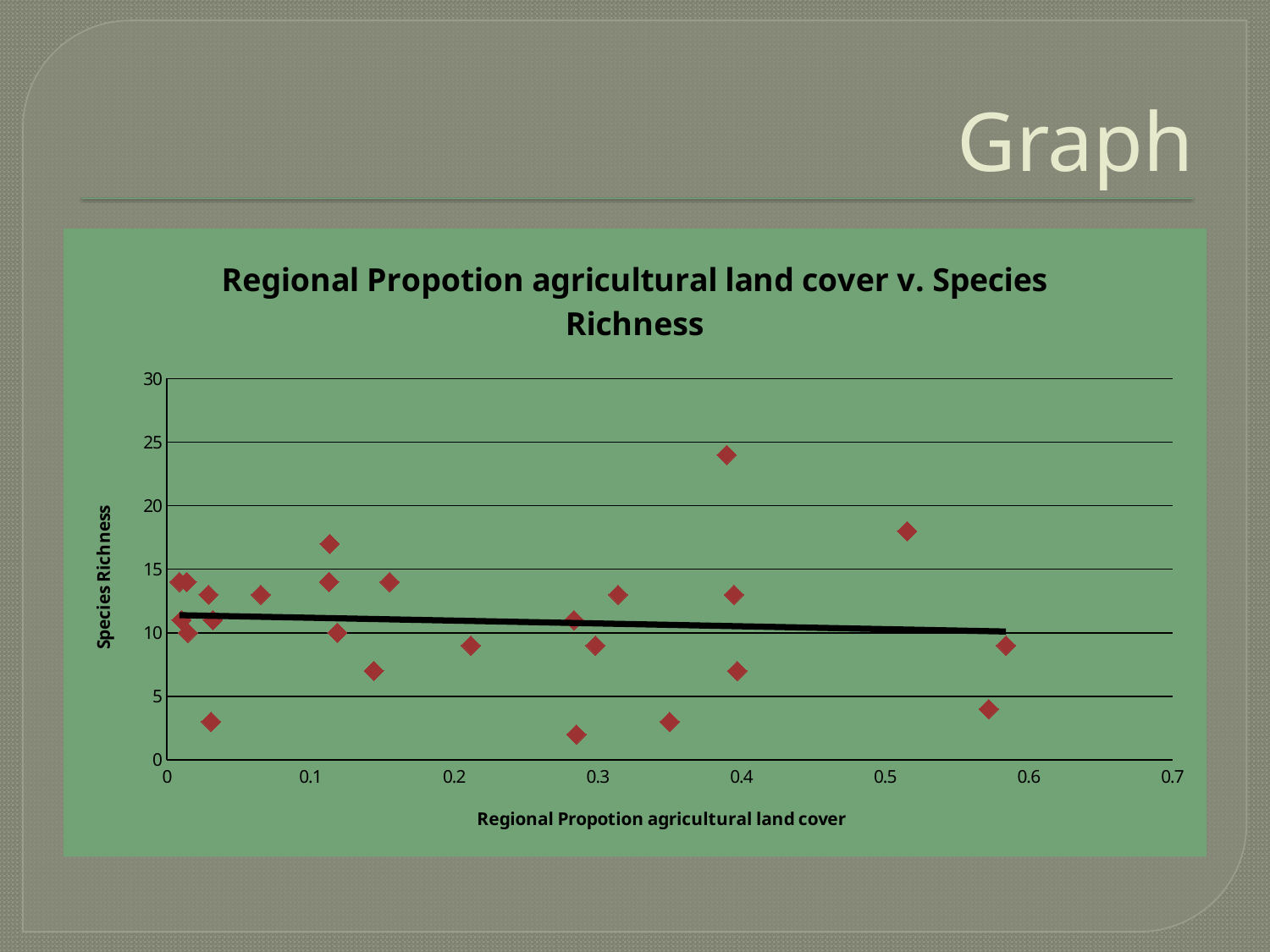
Is the value where the trend line meets the left side of the plot greater or less than 10? greater Is the species richness of the point furthest to the right on the chart greater or less than 10? less Is the species richness of the lowest point on the chart greater or less than 5? less Does the trend line in the chart rise or fall as the regional proportion of agricultural land cover increases? fall What is the title of the chart? Regional Propotion agricultural land cover v. Species Richness Which has the higher species richness: the highest point near 0.4 on the x axis or the point near 0.5 on the x axis? the point near 0.4 What kind of chart is shown on the slide? scatter chart What is the label on the vertical axis of the chart? Species Richness